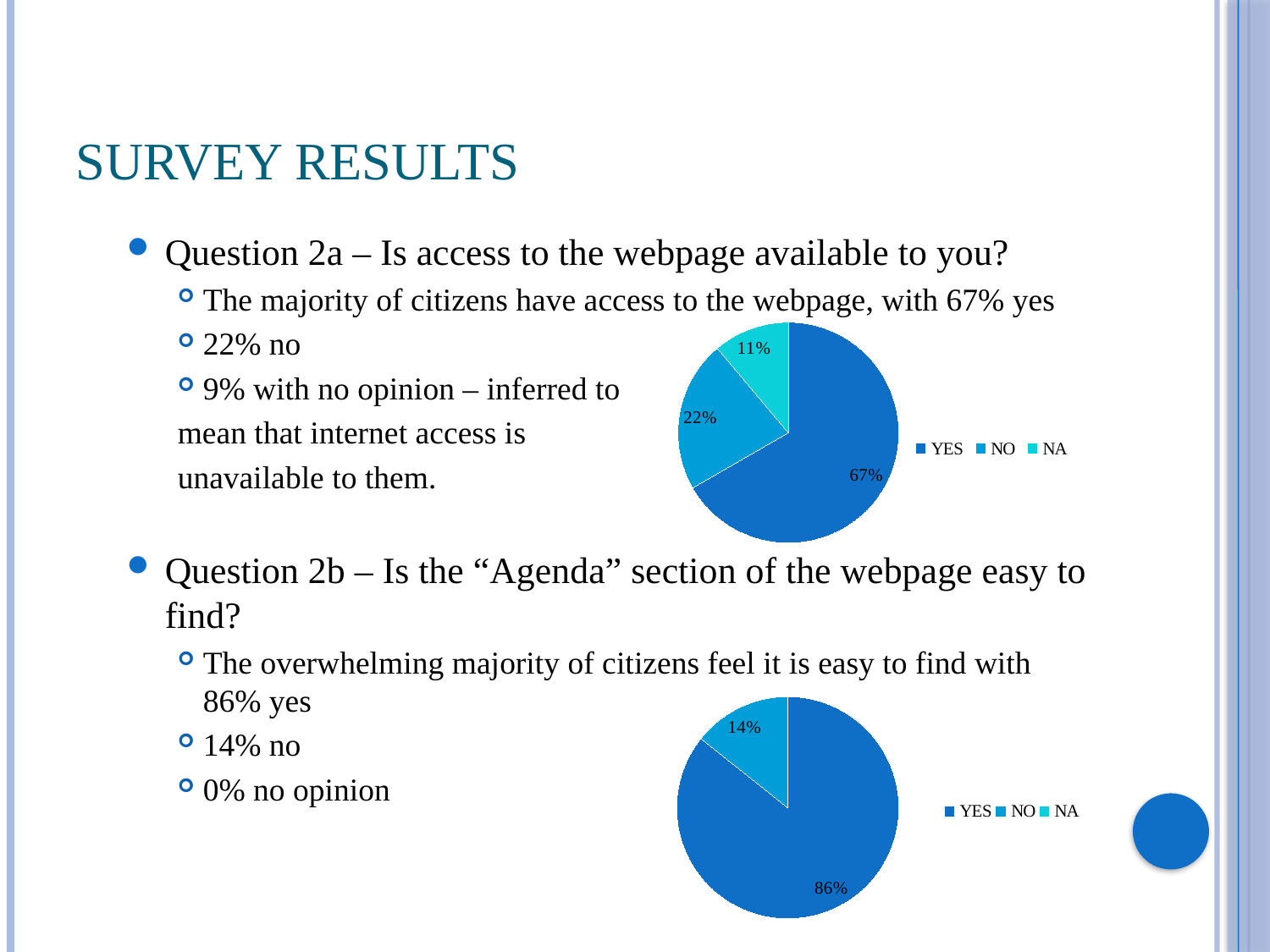
In the bottom pie chart (Question 2b), what is the difference between the YES and NO shares? 72% In the bottom pie chart (Question 2b), what share is labelled for NO? 14% In the top pie chart (Question 2a), what is the difference between the YES and NO shares? 45% In the bottom pie chart (Question 2b), which is larger, YES or NO? YES In the top pie chart (Question 2a), which category has the smallest slice? NA What type of chart is used for the Question 2b results at the bottom of the slide? Pie chart In the top pie chart (Question 2a), what share is labelled for NA? 11% In the top pie chart (Question 2a), how many entries does the legend list? 3 In the top pie chart (Question 2a), what share is labelled for NO? 22% In the top pie chart (Question 2a), what share is labelled for YES? 67% In the bottom pie chart (Question 2b), what share is labelled for YES? 86% In the top pie chart (Question 2a), which category has the largest slice? YES